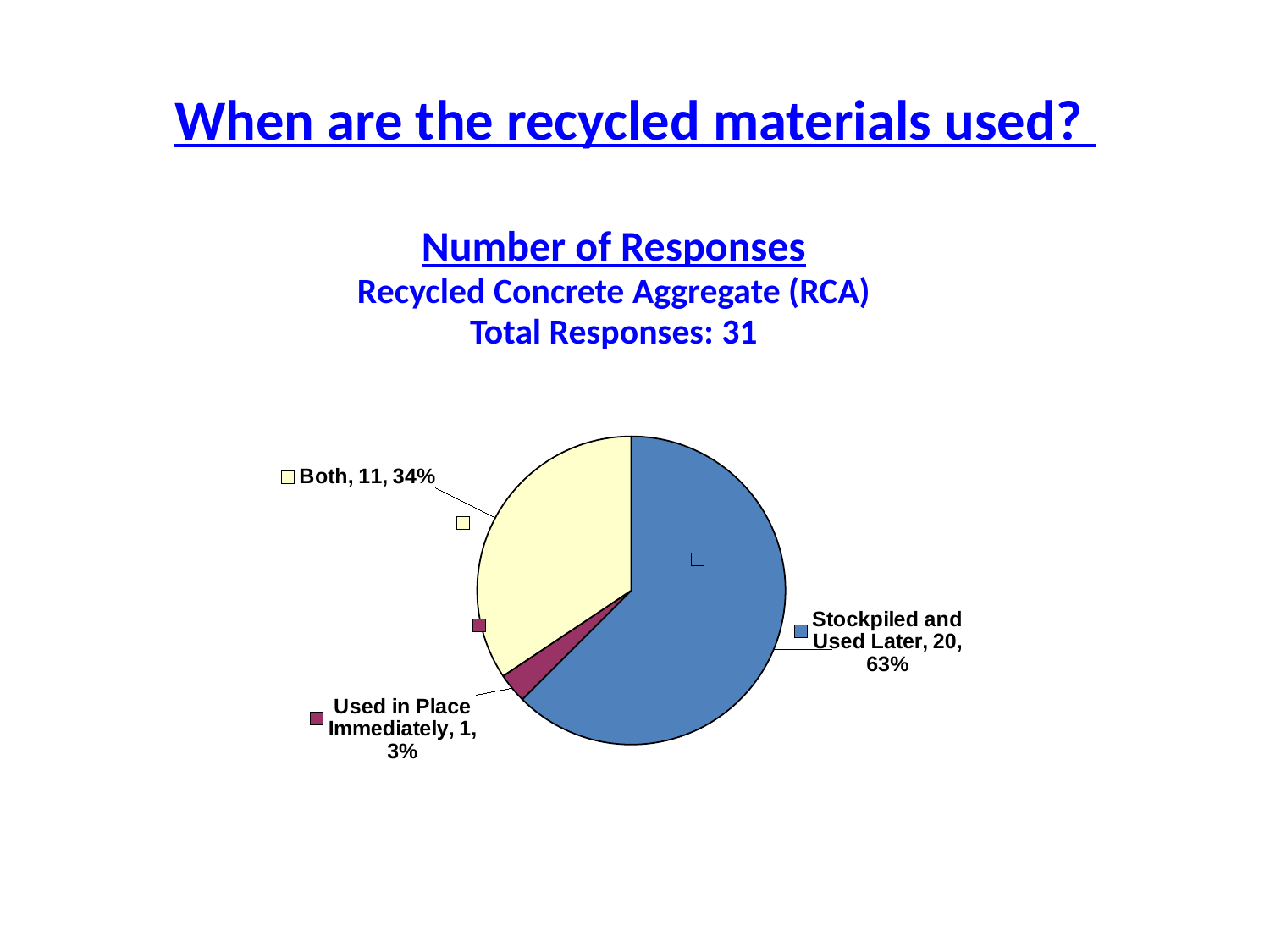
What is the total number of responses stated on the slide? 31 What percentage share does the 'Used in Place Immediately' slice have? 3% How many responses are in the 'Used in Place Immediately' slice? 1 What is the difference in number of responses between 'Stockpiled and Used Later' and 'Both'? 9 What percentage share does the 'Stockpiled and Used Later' slice have? 63% Which category has the smallest slice of the pie? Used in Place Immediately What kind of chart is shown on the slide? pie chart Which category has the largest slice of the pie? Stockpiled and Used Later How many slices does the pie chart have? 3 How many responses are in the 'Both' slice? 11 How many responses are in the 'Stockpiled and Used Later' slice? 20 What percentage share does the 'Both' slice have? 34%